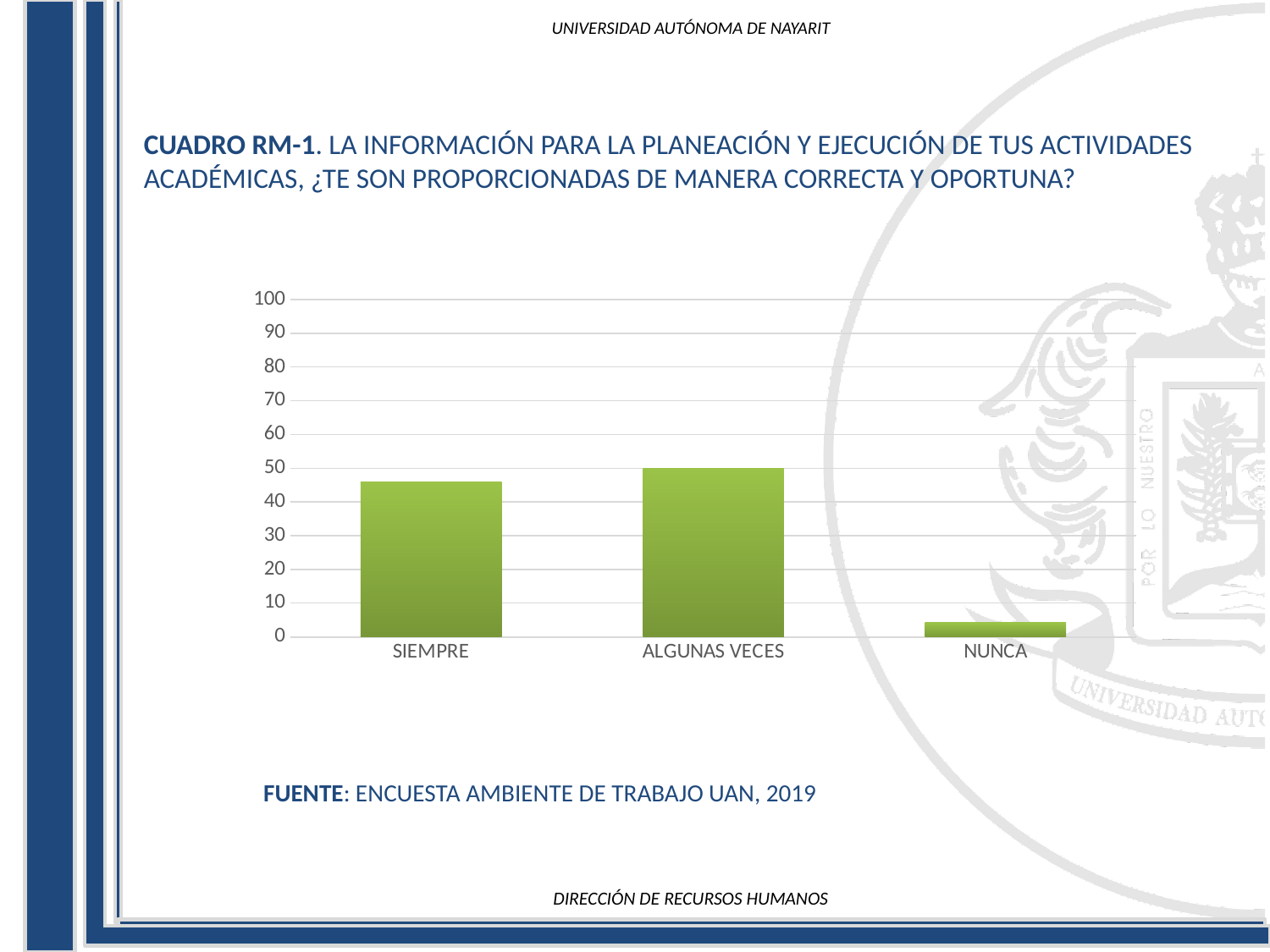
Is the value for SIEMPRE greater or less than 50? less What kind of chart is shown on the slide? bar chart Which is larger, the value for ALGUNAS VECES or the value for SIEMPRE? ALGUNAS VECES Which is larger, the value for SIEMPRE or the value for NUNCA? SIEMPRE What is the maximum value shown on the y axis of the chart? 100 Which category has the highest bar in the chart? ALGUNAS VECES Is the value for SIEMPRE greater or less than 40? greater Is the value for NUNCA greater or less than 10? less What is the value for ALGUNAS VECES in the chart? 50 Which category has the lowest bar in the chart? NUNCA What source is cited below the chart? ENCUESTA AMBIENTE DE TRABAJO UAN, 2019 How many categories are shown on the x axis of the chart? 3